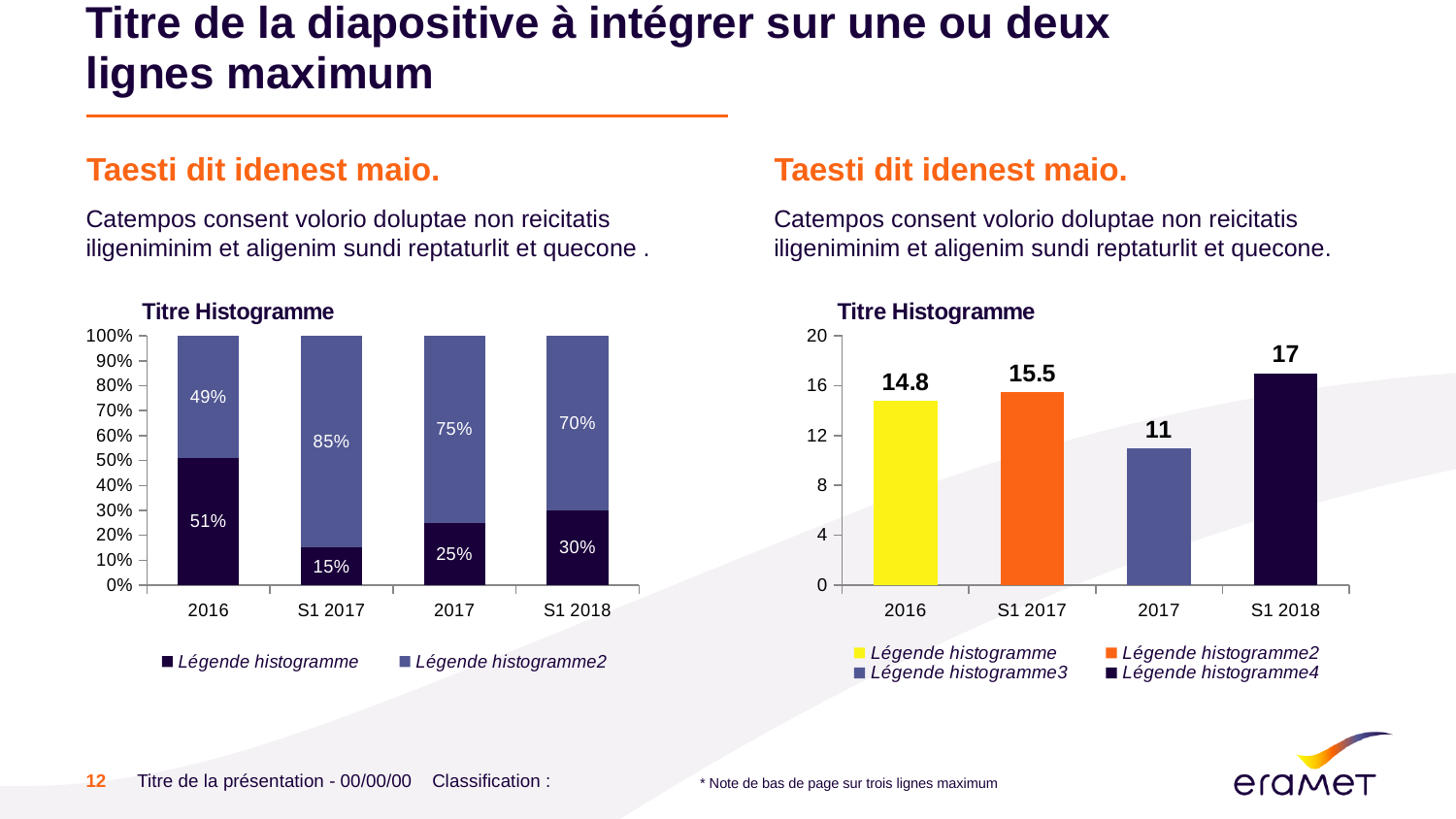
In the right chart, which category has the highest value? S1 2018 In the left chart, how many series does the legend list? 2 In the left chart, which category has the lowest value for Légende histogramme? S1 2017 In the left chart, what is the value of Légende histogramme2 for S1 2017? 85% In the left chart, what is the value of Légende histogramme for 2016? 51% In the right chart, how many series does the legend list? 4 In the right chart, what is the value for S1 2017? 15.5 In the right chart, what is the difference between the values for S1 2018 and 2017? 6 In the left chart, what is the value of Légende histogramme for S1 2018? 30% In the left chart, what is the difference between the Légende histogramme2 value for 2017 and the Légende histogramme value for 2017? 50% In the left chart, which category has the highest value for Légende histogramme2? S1 2017 In the right chart, which category has the lowest value? 2017